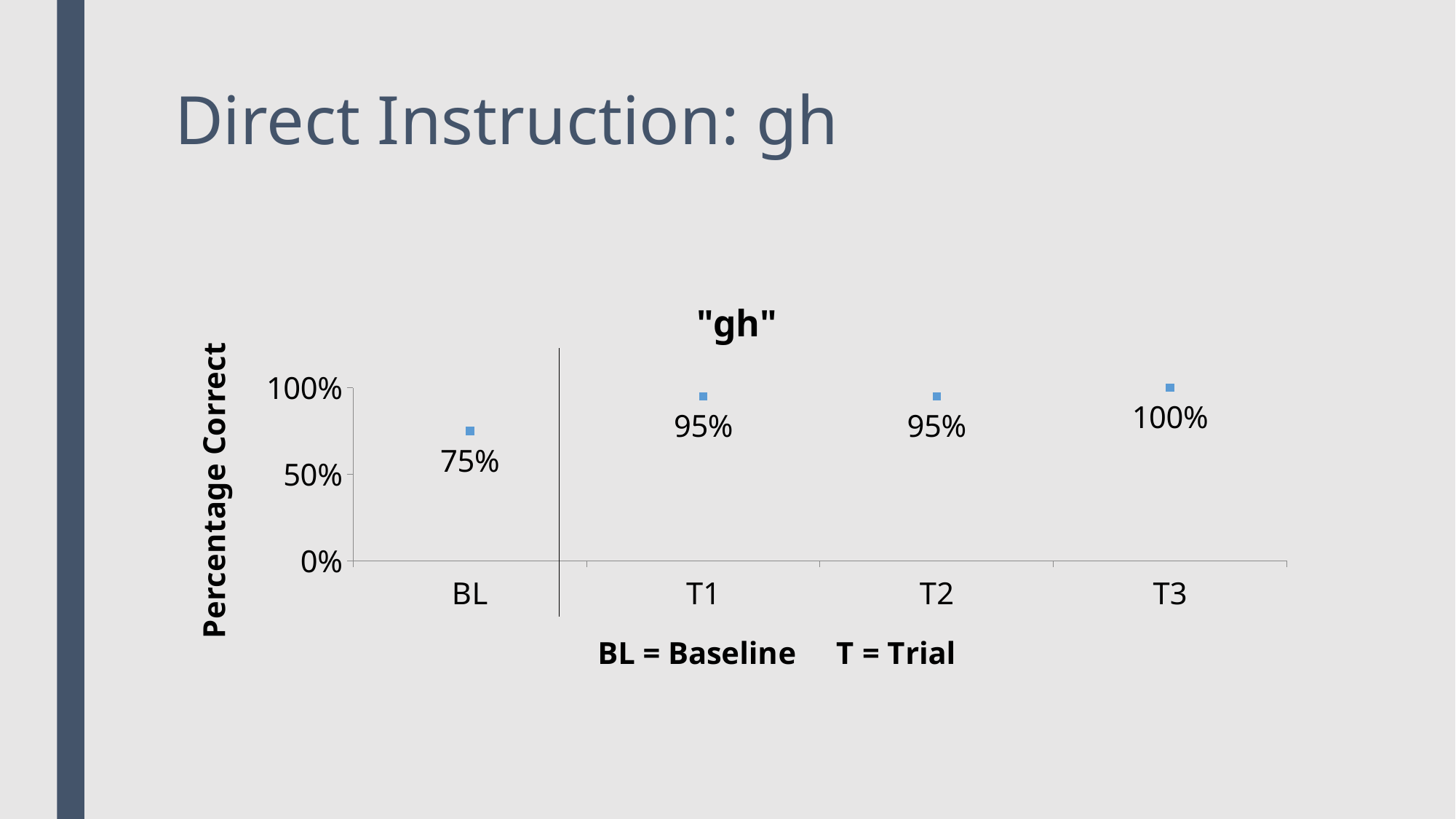
What is the percentage correct at BL? 75% Which point has the highest percentage correct? T3 Do the values generally rise or fall from BL to T3? rise What is the difference in percentage correct between T1 and BL? 20% Which is larger, the value at BL or the value at T2? T2 How many data points are plotted on the chart? 4 What is the difference in percentage correct between T3 and BL? 25% What is the percentage correct at T3? 100% What is the percentage correct at T1? 95% Is the value for BL greater or less than 50%? greater What is the title of the chart? "gh" Which point has the lowest percentage correct? BL